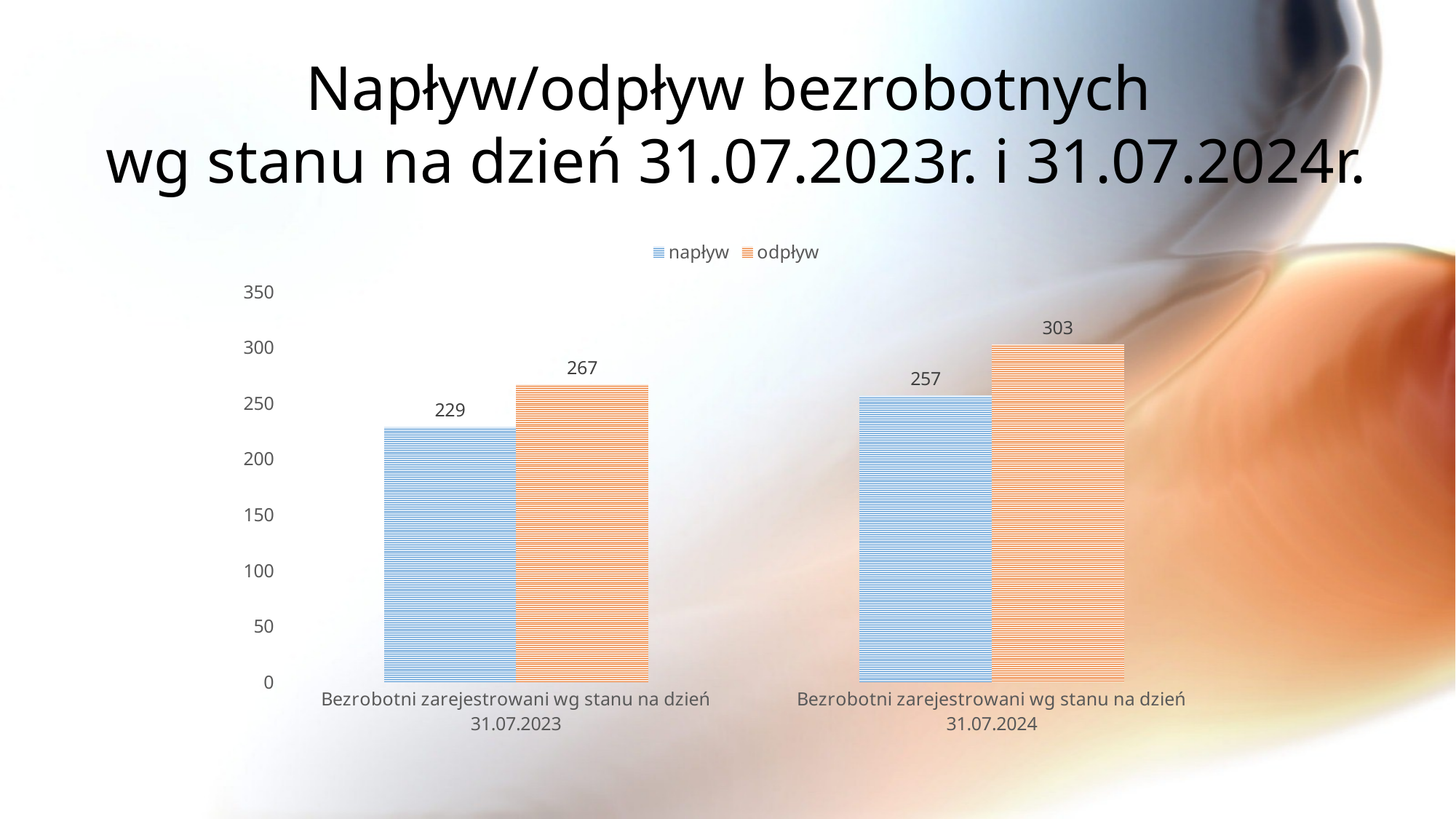
What is the value of napływ for 31.07.2024? 257 Which colour represents the odpływ series? orange Which bar has the highest value on the chart? odpływ for 31.07.2024 What is the value of odpływ for 31.07.2023? 267 Which bar has the lowest value on the chart? napływ for 31.07.2023 What is the value of napływ for 31.07.2023? 229 How many series does the legend list? 2 By how much did napływ increase from 31.07.2023 to 31.07.2024? 28 What is the difference between odpływ and napływ for 31.07.2024? 46 What is the value of odpływ for 31.07.2024? 303 Which is larger for 31.07.2023, napływ or odpływ? odpływ What kind of chart is shown on the slide? bar chart